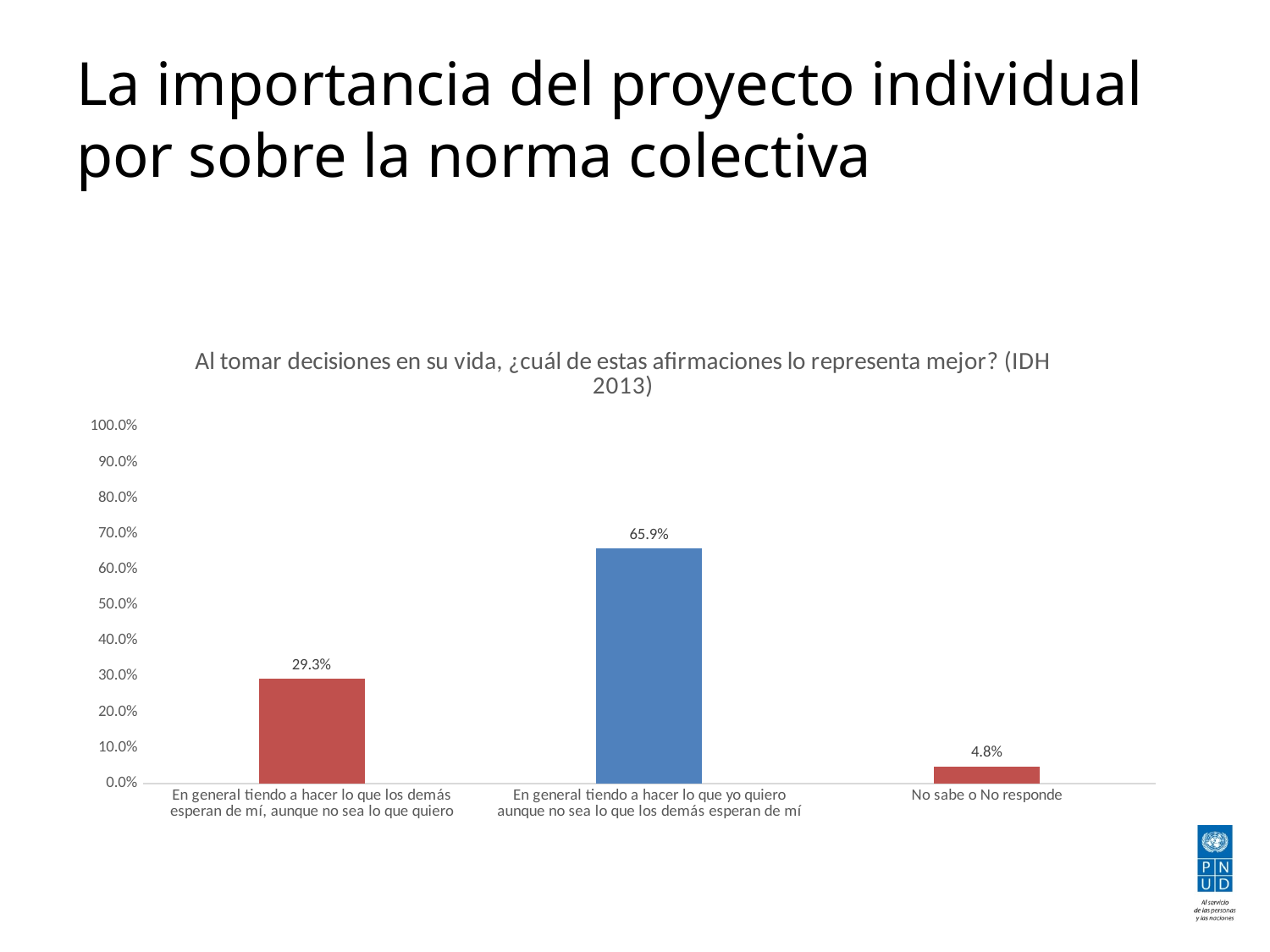
What kind of chart is shown on the slide? Bar chart What is the title of the chart? Al tomar decisiones en su vida, ¿cuál de estas afirmaciones lo representa mejor? (IDH 2013) What is the value for "No sabe o No responde"? 4.8% Which category has the lowest value? No sabe o No responde Is the value for "En general tiendo a hacer lo que yo quiero aunque no sea lo que los demás esperan de mí" greater or less than 60.0%? greater Is the value for "No sabe o No responde" greater or less than 10.0%? less What is the value for "En general tiendo a hacer lo que yo quiero aunque no sea lo que los demás esperan de mí"? 65.9% Which is larger: the value for "En general tiendo a hacer lo que los demás esperan de mí, aunque no sea lo que quiero" or the value for "No sabe o No responde"? En general tiendo a hacer lo que los demás esperan de mí, aunque no sea lo que quiero Which category has the highest value? En general tiendo a hacer lo que yo quiero aunque no sea lo que los demás esperan de mí What is the value for "En general tiendo a hacer lo que los demás esperan de mí, aunque no sea lo que quiero"? 29.3% What is the difference between the value for "En general tiendo a hacer lo que yo quiero aunque no sea lo que los demás esperan de mí" and the value for "En general tiendo a hacer lo que los demás esperan de mí, aunque no sea lo que quiero"? 36.6% How many categories are shown on the x axis? 3